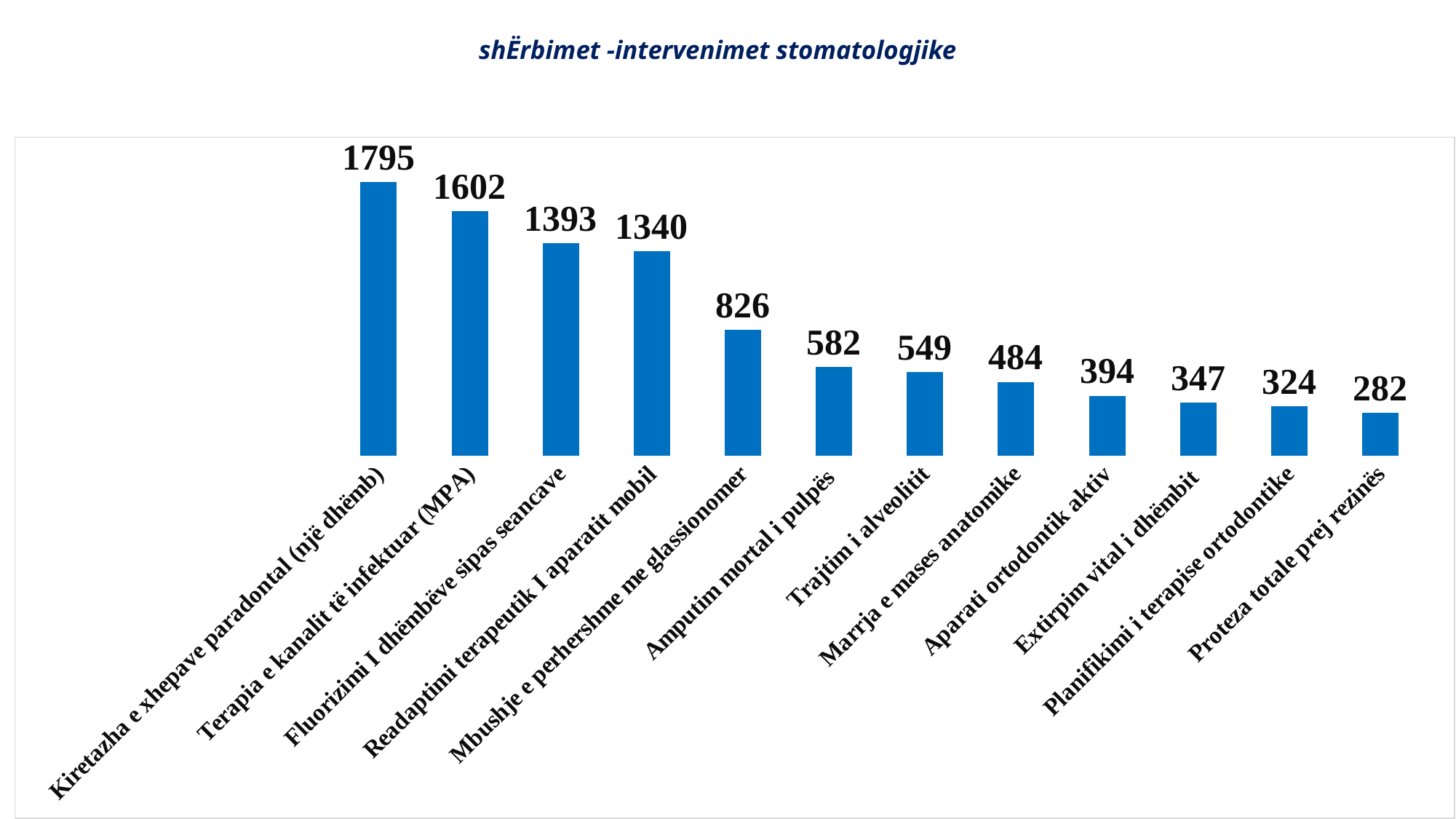
Which is larger, the value for Readaptimi terapeutik I aparatit mobil or the value for Marrja e mases anatomike? Readaptimi terapeutik I aparatit mobil What is the value for Kiretazha e xhepave paradontal (një dhëmb)? 1795 What kind of chart is shown on the slide? bar chart Which category has the highest value? Kiretazha e xhepave paradontal (një dhëmb) What is the value for Mbushje e perhershme me glassionomer? 826 What is the value for Aparati ortodontik aktiv? 394 What is the title of the chart? shËrbimet -intervenimet stomatologjike What is the difference between the values for Amputim mortal i pulpës and Trajtim i alveolitit? 33 How many categories are shown in the chart? 12 Do the values rise or fall from left to right along the x axis? fall Which category has the lowest value? Proteza totale prej rezinës What is the difference between the values for Terapia e kanalit të infektuar (MPA) and Fluorizimi I dhëmbëve sipas seancave? 209